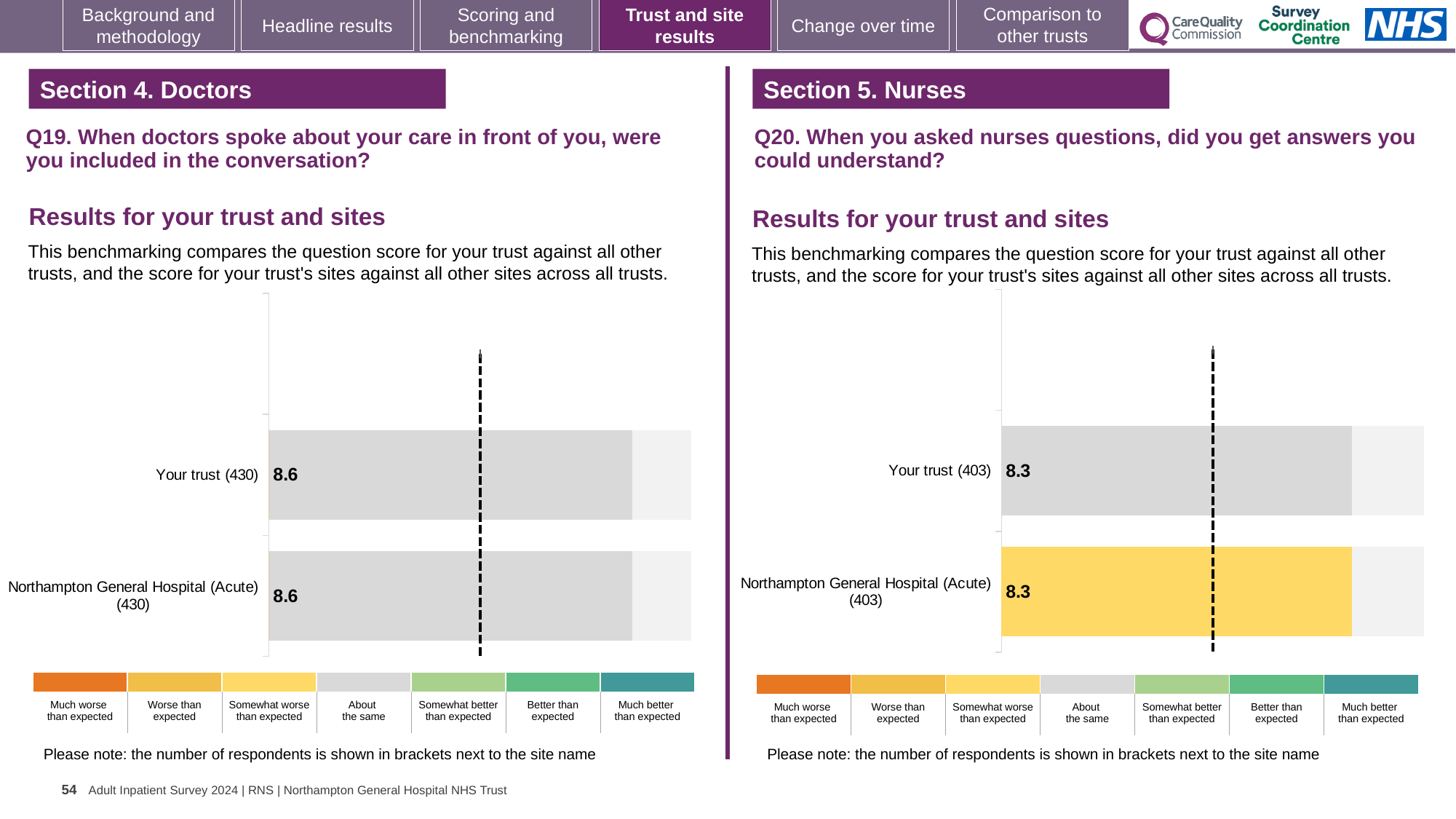
On the Q20 chart (Section 5. Nurses), what is the difference between the score for Your trust and the score for Northampton General Hospital (Acute)? 0 On the Q19 chart (Section 4. Doctors), how many respondents are shown in brackets for Your trust? 430 On the Q19 chart (Section 4. Doctors), what is the score for Your trust? 8.6 On the Q20 chart (Section 5. Nurses), what is the score for Your trust? 8.3 On the Q19 chart (Section 4. Doctors), what is the difference between the score for Your trust and the score for Northampton General Hospital (Acute)? 0 On the Q19 chart (Section 4. Doctors), what is the score for Northampton General Hospital (Acute)? 8.6 How many bars are plotted on the Q20 chart (Section 5. Nurses)? 2 How many bars are plotted on the Q19 chart (Section 4. Doctors)? 2 On the Q20 chart (Section 5. Nurses), what is the score for Northampton General Hospital (Acute)? 8.3 Is the score for Your trust on the Q20 chart (Section 5. Nurses) greater or less than the score for Your trust on the Q19 chart (Section 4. Doctors)? less On the Q20 chart (Section 5. Nurses), how many respondents are shown in brackets for Northampton General Hospital (Acute)? 403 What kind of chart is used for the Q19 results (Section 4. Doctors)? Bar chart